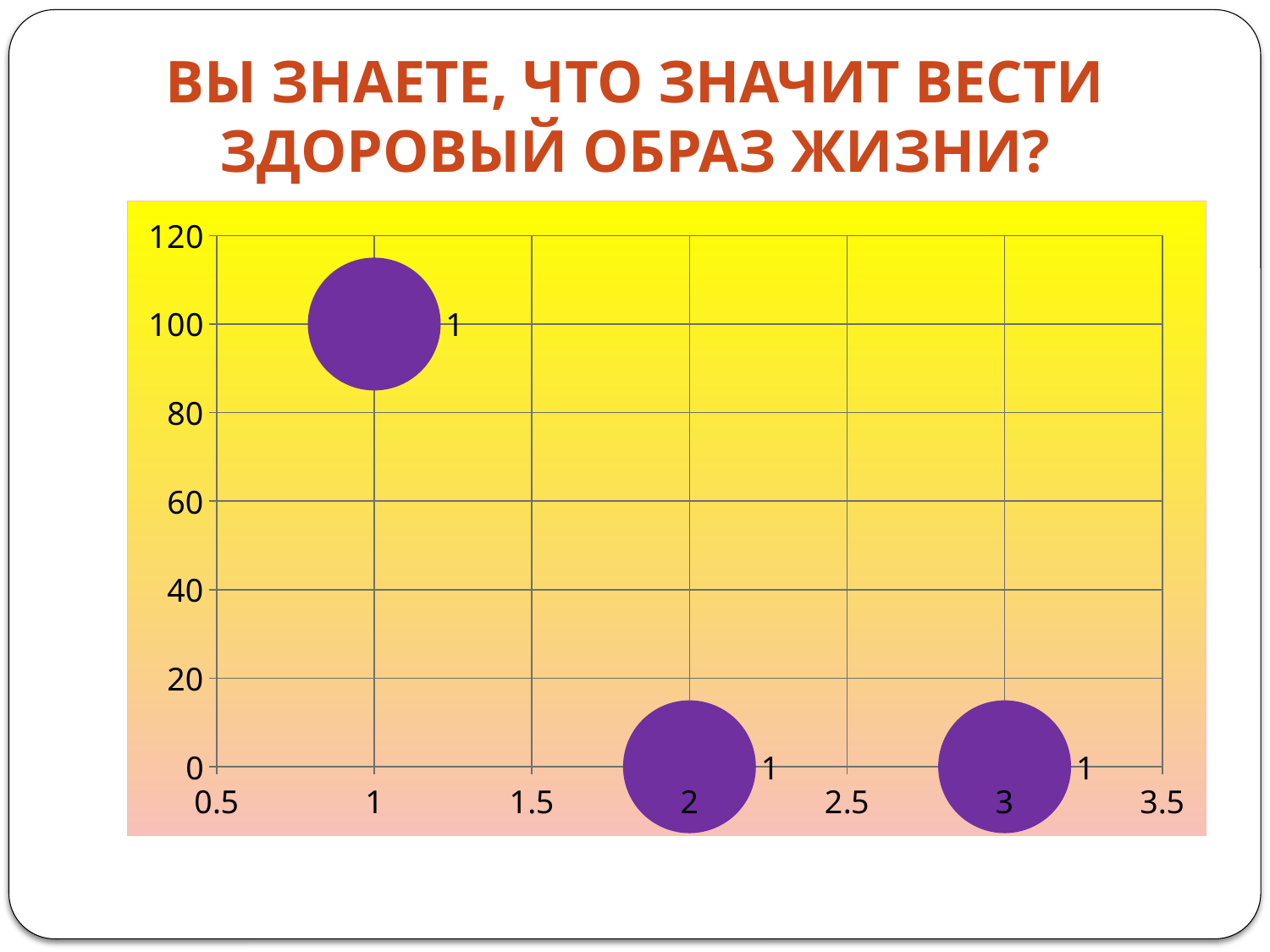
Which bubble has a larger y value, the one at x = 1 or the one at x = 3? the one at x = 1 Is the y value of the bubble at x = 2 greater or less than 20? less What is the y-axis value of the bubble at x = 2? 0 What data label is printed next to each bubble? 1 What is the maximum value shown on the y axis? 120 Is the y value of the bubble at x = 1 greater or less than 80? greater At which x value is the bubble with the highest y value located? 1 How many bubbles are plotted on the chart? 3 What kind of chart is shown on the slide? bubble chart What is the difference between the y value of the bubble at x = 1 and the bubble at x = 2? 100 What is the y-axis value of the bubble at x = 3? 0 What is the y-axis value of the bubble at x = 1? 100